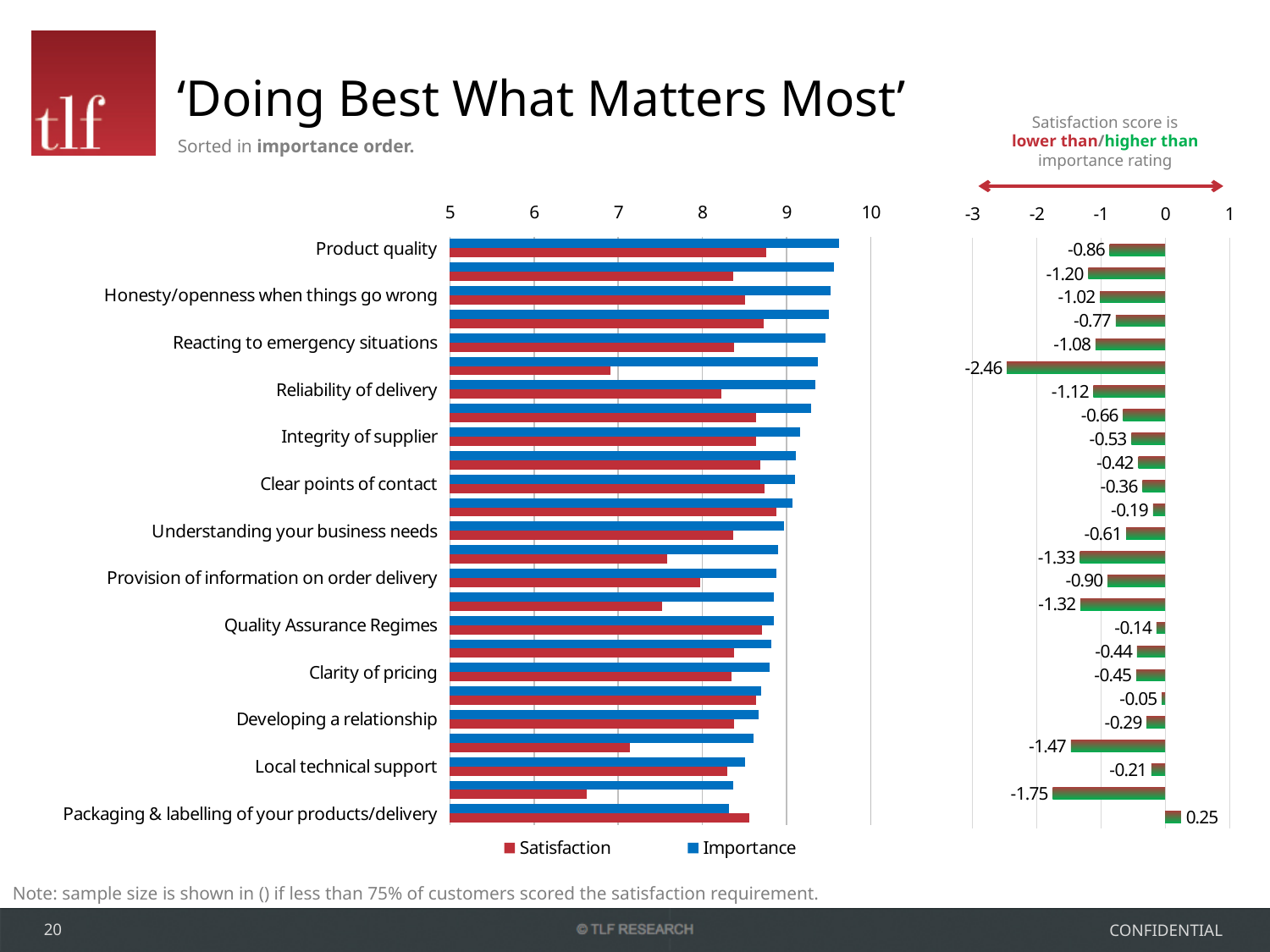
How many series does the legend of the left-hand chart list? 2 On the left-hand chart, which is larger for Product quality, Satisfaction or Importance? Importance On the right-hand chart, what is the difference between the values for Product quality and Reliability of delivery? 0.26 On the right-hand chart, what is the value shown for Quality Assurance Regimes? -0.14 On the left-hand chart, is the Importance value for Product quality greater or less than 9? greater On the right-hand chart, what is the value shown for Provision of information on order delivery? -0.90 On the right-hand chart, what is the value shown for Packaging & labelling of your products/delivery? 0.25 On the right-hand chart, which labelled category has the highest value? Packaging & labelling of your products/delivery On the right-hand chart, what is the value shown for Product quality? -0.86 What kind of chart is the left-hand chart? Bar chart On the right-hand chart, what is the lowest value shown? -2.46 On the right-hand chart, what is the value shown for Reliability of delivery? -1.12